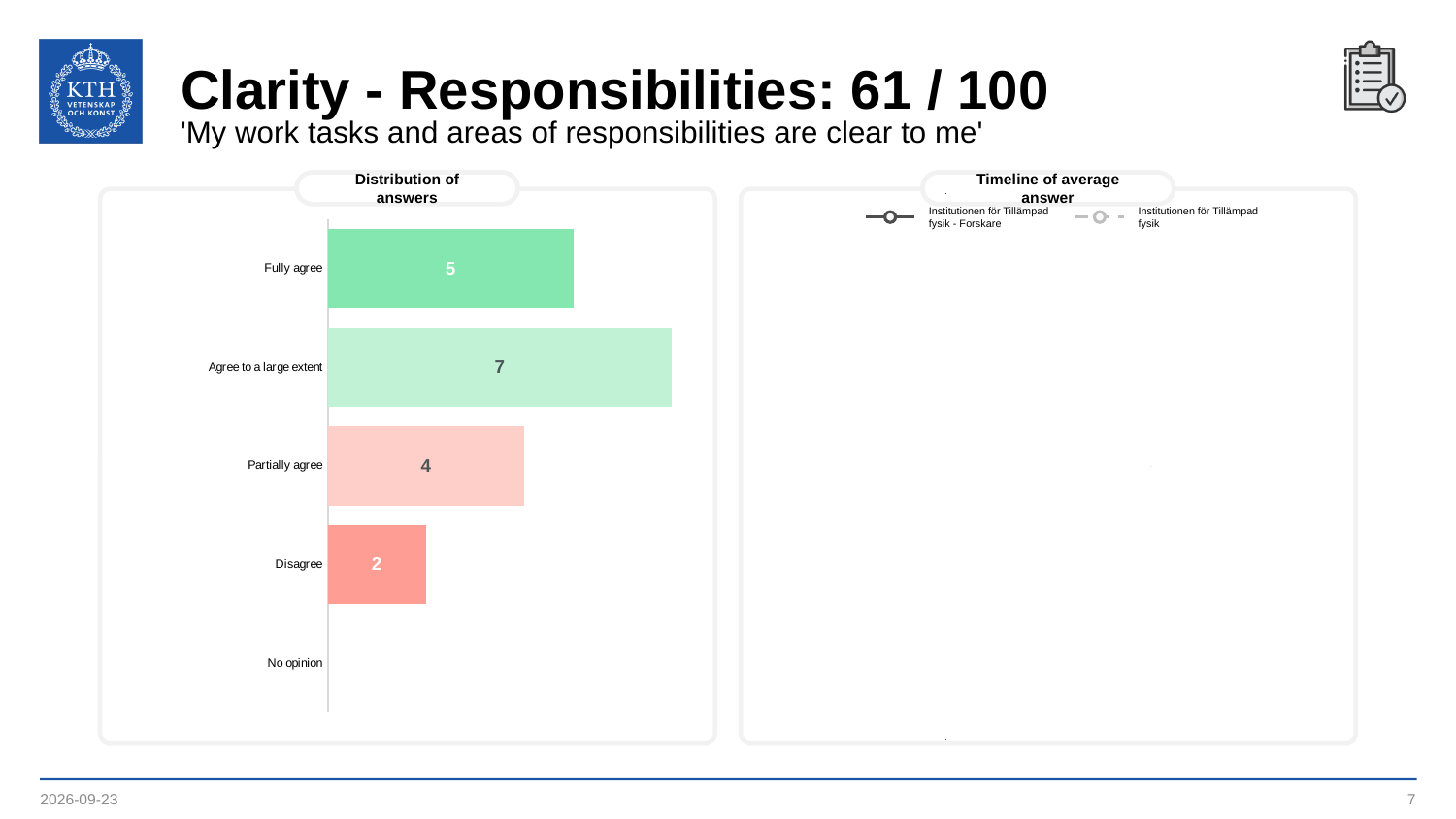
In the 'Distribution of answers' chart, what is the value for 'Agree to a large extent'? 7 In the 'Distribution of answers' chart, what is the difference between 'Agree to a large extent' and 'Disagree'? 5 In the 'Distribution of answers' chart, what is the value for 'Partially agree'? 4 How many answer categories are listed on the y axis of the 'Distribution of answers' chart? 5 In the 'Distribution of answers' chart, what is the value for 'Disagree'? 2 What kind of chart is the 'Distribution of answers' chart? Bar chart In the 'Distribution of answers' chart, which is larger: 'Fully agree' or 'Partially agree'? Fully agree In the 'Distribution of answers' chart, how many respondents chose 'Fully agree'? 5 In the 'Distribution of answers' chart, which answer category with a visible bar has the lowest value? Disagree How many series does the legend of the 'Timeline of average answer' chart list? 2 What is the title of the chart on the left side of the slide? Distribution of answers In the 'Distribution of answers' chart, which answer category has the highest value? Agree to a large extent